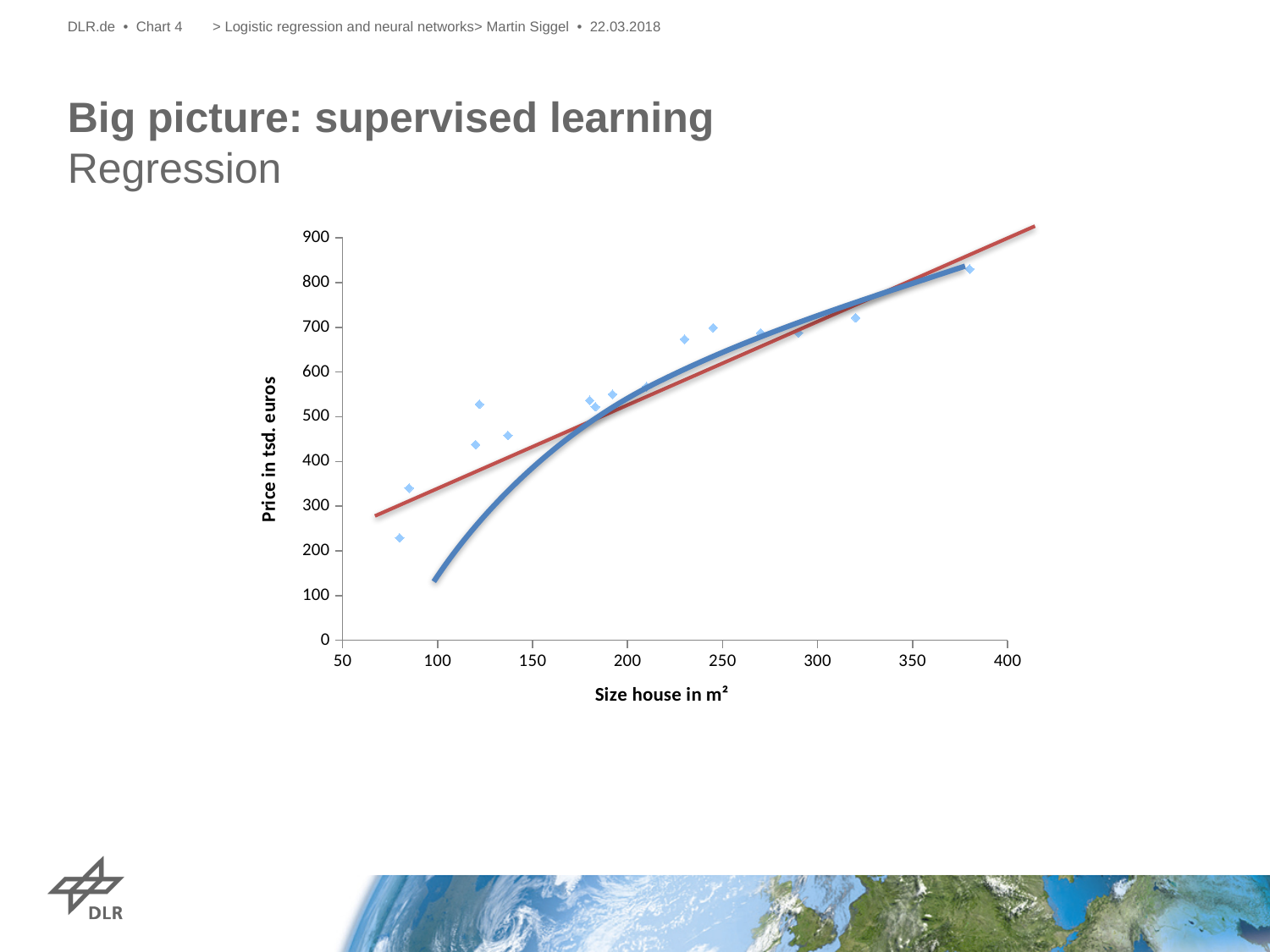
What is the label of the y axis? Price in tsd. euros Is the price of the largest house (around 380 m²) greater or less than 800? greater Is the price of the smallest house (around 80 m²) greater or less than 300? less Which has the higher price: the house at about 80 m² or the house at about 380 m²? the house at about 380 m² At 100 m², which fitted line is higher: the red straight line or the blue curve? the red straight line What is the label of the x axis? Size house in m² Is the price of the house at about 120 m² with the higher price greater or less than 500? greater What kind of chart is shown on the slide? scatter chart Do the plotted prices generally rise or fall as house size increases? rise